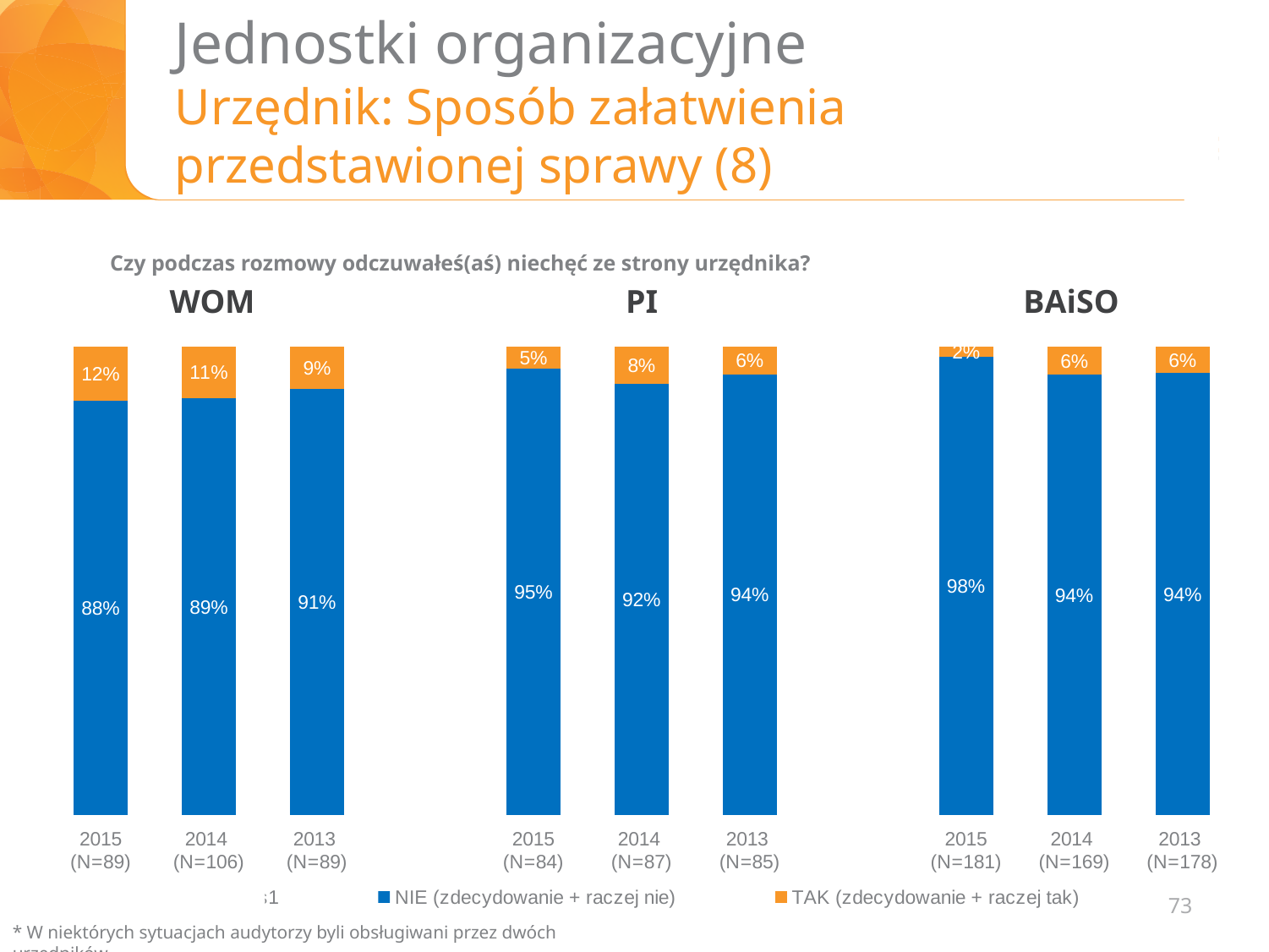
In the WOM chart, which year has the highest TAK (zdecydowanie + raczej tak) value? 2015 (N=89) What type of chart is used for the PI data? stacked bar chart In the WOM chart, what is the difference between the NIE values for 2013 (N=89) and 2015 (N=89)? 3% How many bars are shown in the WOM chart? 3 How many series does the legend list? 2 In the PI chart, what is the TAK (zdecydowanie + raczej tak) value for 2014 (N=87)? 8% In the BAiSO chart, is the TAK value for 2015 (N=181) larger or smaller than the TAK value for 2014 (N=169)? smaller In the BAiSO chart, what is the NIE (zdecydowanie + raczej nie) value for 2015 (N=181)? 98% In the PI chart, what is the total of the stacked bar for 2015 (N=84)? 100% In the PI chart, which year has the lowest NIE (zdecydowanie + raczej nie) value? 2014 (N=87) In the WOM chart, does the NIE (zdecydowanie + raczej nie) value rise or fall from 2015 to 2013 along the x axis? rise In the WOM chart, what is the NIE (zdecydowanie + raczej nie) value for 2015 (N=89)? 88%